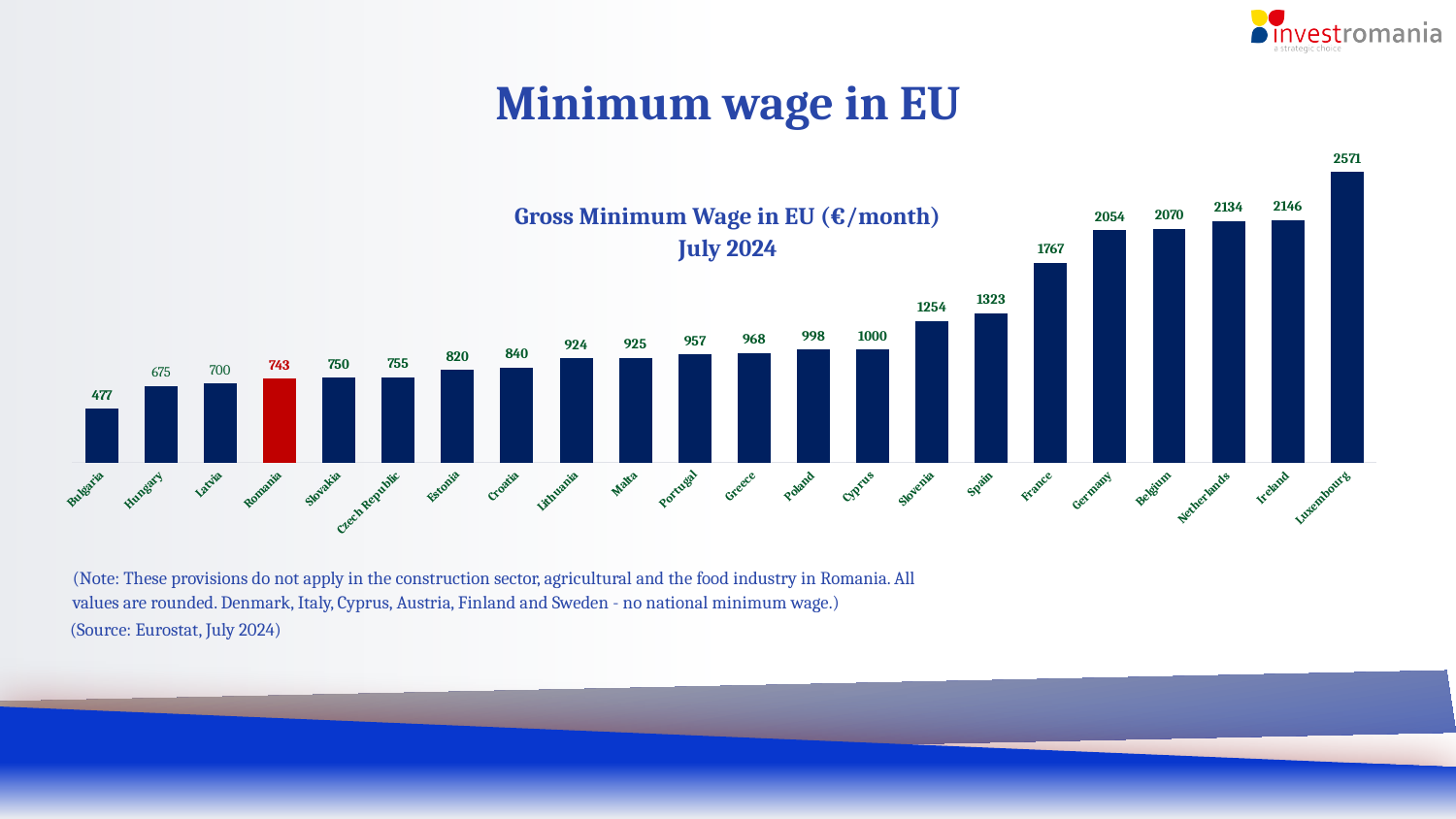
How many countries are shown in the chart? 22 Which has a higher gross minimum wage, Spain or France? France What is the gross minimum wage shown for Romania? 743 Which has a higher gross minimum wage, Hungary or Estonia? Estonia Which country's bar is highlighted in red in the chart? Romania What is the gross minimum wage shown for Slovenia? 1254 What is the gross minimum wage shown for Germany? 2054 Which country has the highest gross minimum wage in the chart? Luxembourg Which country has the lowest gross minimum wage in the chart? Bulgaria What is the difference between the gross minimum wage of Luxembourg and Bulgaria? 2094 What is the difference between the gross minimum wage of Ireland and Netherlands? 12 What kind of chart is used to show the gross minimum wage in EU? Bar chart